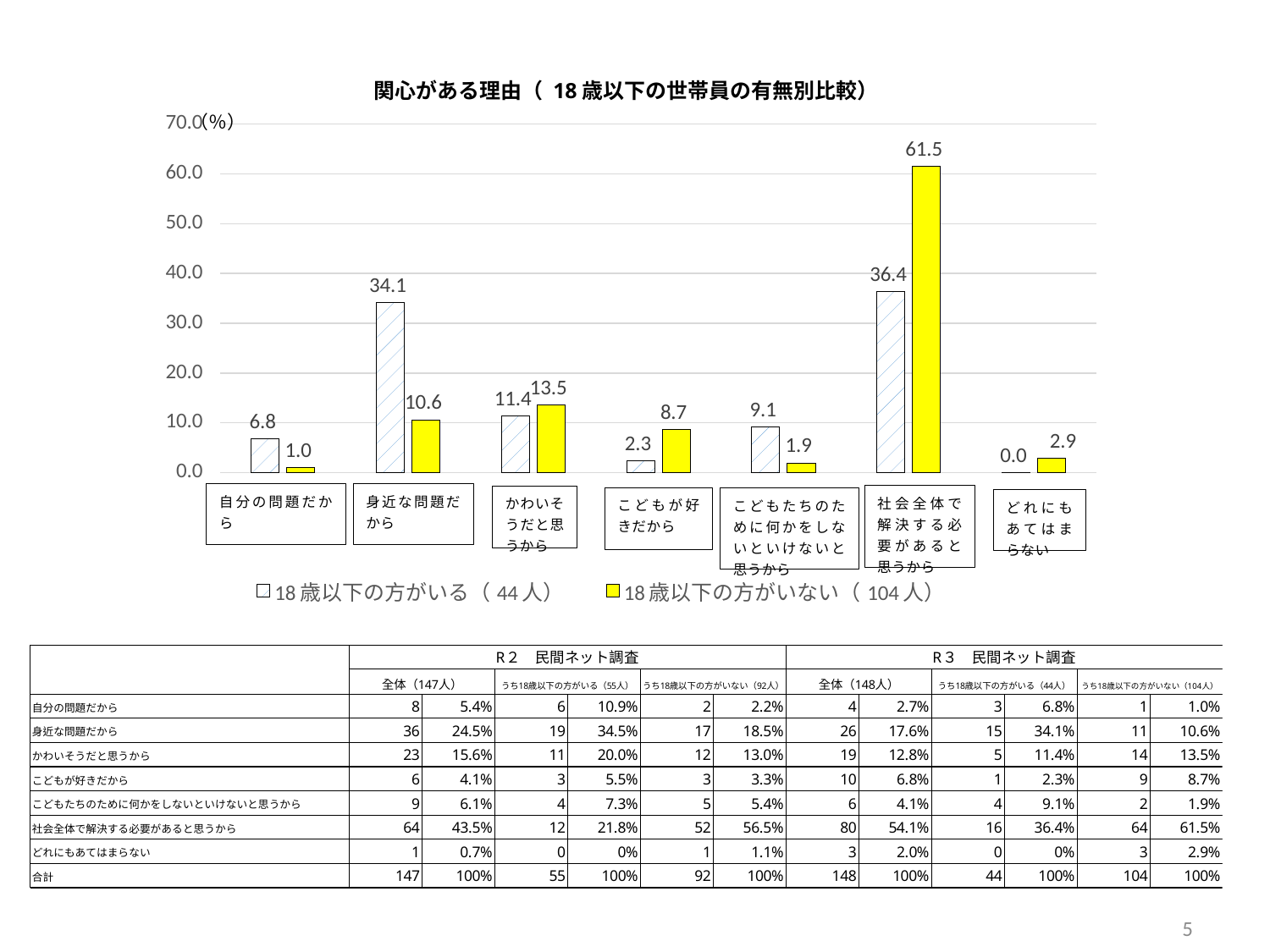
Which category has the highest value in the 18歳以下の方がいる（44人） series? 社会全体で解決する必要があると思うから What is the value for 社会全体で解決する必要があると思うから in the 18歳以下の方がいない（104人） series? 61.5 What is the title of the chart? 関心がある理由（18歳以下の世帯員の有無別比較） For 身近な問題だから, which series has the larger value? 18歳以下の方がいる（44人） How many categories are shown on the x axis of the chart? 7 Which category has the lowest value in the 18歳以下の方がいない（104人） series? 自分の問題だから What is the value for こどもが好きだから in the 18歳以下の方がいない（104人） series? 8.7 What is the difference between the two series for 社会全体で解決する必要があると思うから? 25.1 How many series does the chart legend list? 2 Is the value for 社会全体で解決する必要があると思うから in the 18歳以下の方がいない（104人） series greater or less than 60.0? greater What kind of chart is shown on the slide? bar chart What is the value for 自分の問題だから in the 18歳以下の方がいる（44人） series? 6.8